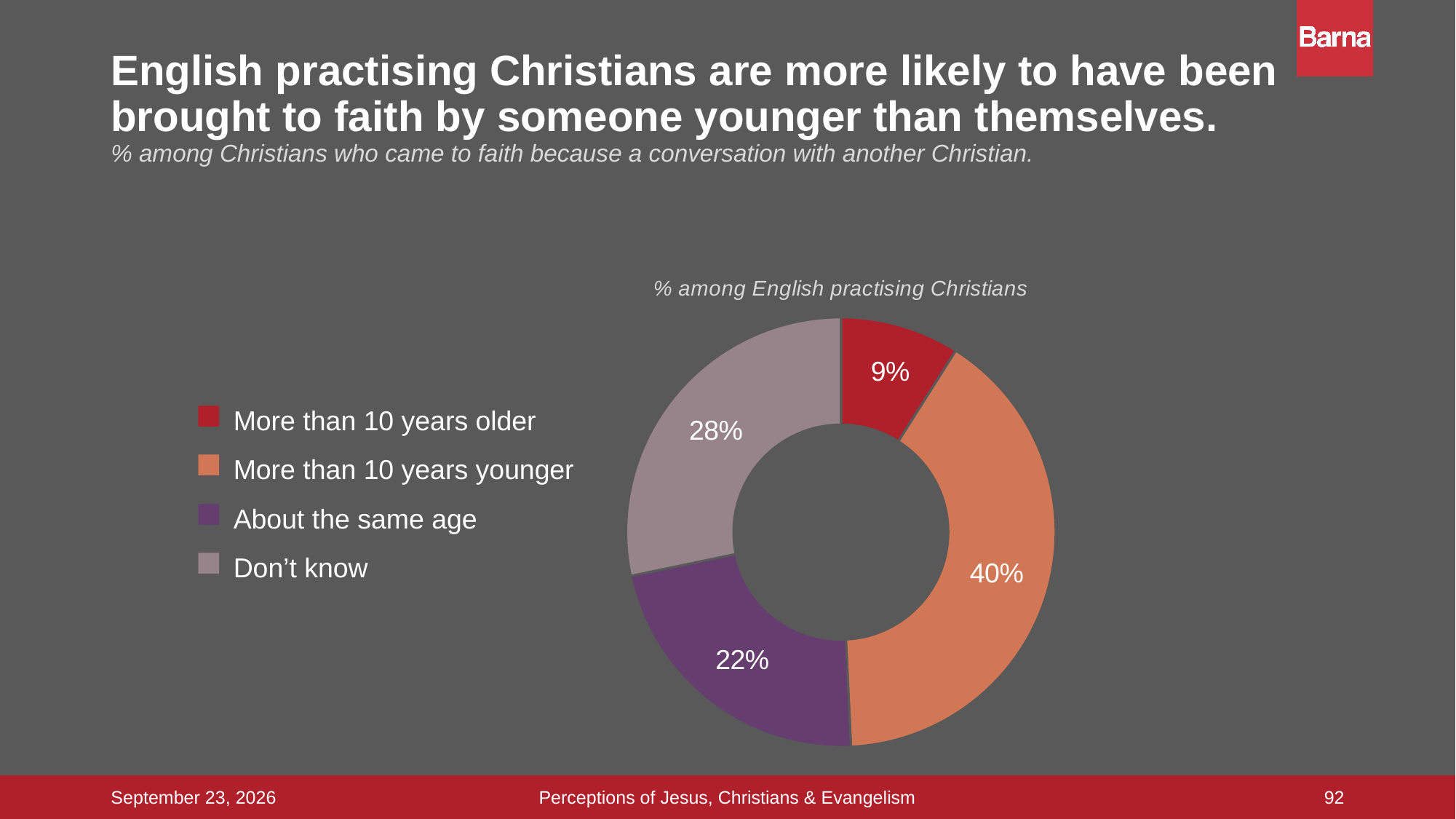
What percentage of English practising Christians answered 'About the same age'? 22% How many categories are shown in the pie chart? 4 What percentage of English practising Christians answered 'Don't know'? 28% What is the difference in percentage points between 'More than 10 years younger' and 'More than 10 years older'? 31 Which category has the largest share of the pie? More than 10 years younger Which category has the smallest share of the pie? More than 10 years older What colour represents 'About the same age' in the chart? Purple What percentage of English practising Christians were brought to faith by someone more than 10 years younger? 40% What kind of chart is shown on the slide? Doughnut chart What percentage of English practising Christians were brought to faith by someone more than 10 years older? 9% What is the difference in percentage points between 'Don't know' and 'About the same age'? 6 Which is larger: the share for 'Don't know' or the share for 'About the same age'? Don't know